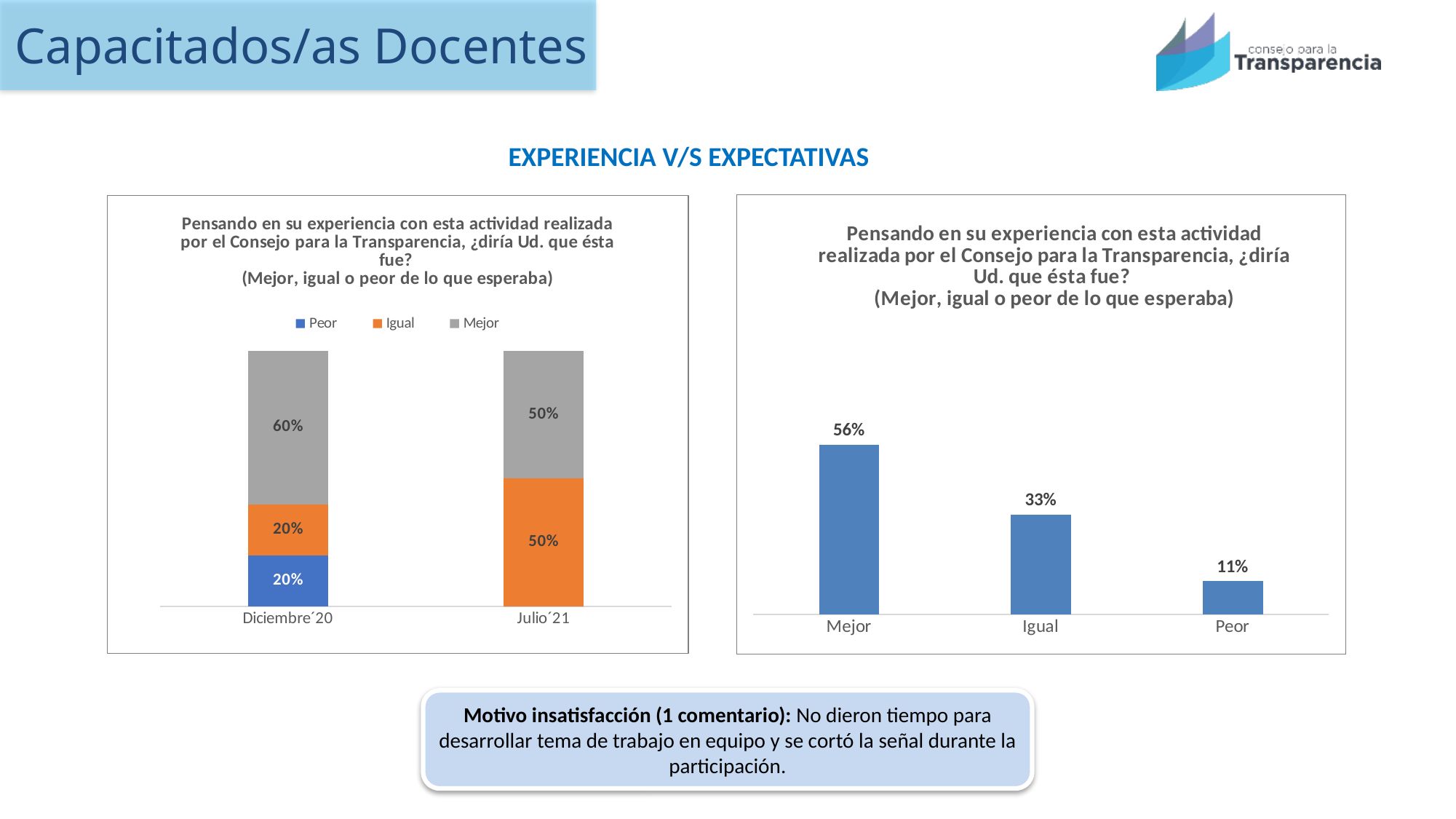
In the left chart, what is the difference between the Mejor values for Diciembre´20 and Julio´21? 10% In the left chart, what is the value for Igual in Julio´21? 50% What kind of chart is the right chart? Bar chart In the left chart, what is the value for Mejor in Diciembre´20? 60% In the right chart, which category has the highest value? Mejor In the right chart, which category has the lowest value? Peor In the right chart, what is the difference between the values for Mejor and Peor? 45% In the left chart, what is the total of the stacked bar for Diciembre´20? 100% In the left chart, how many series does the legend list? 3 In the left chart, what is the value for Peor in Diciembre´20? 20% In the right chart, what is the value for Igual? 33% In the left chart, which colour represents the Igual series? Orange